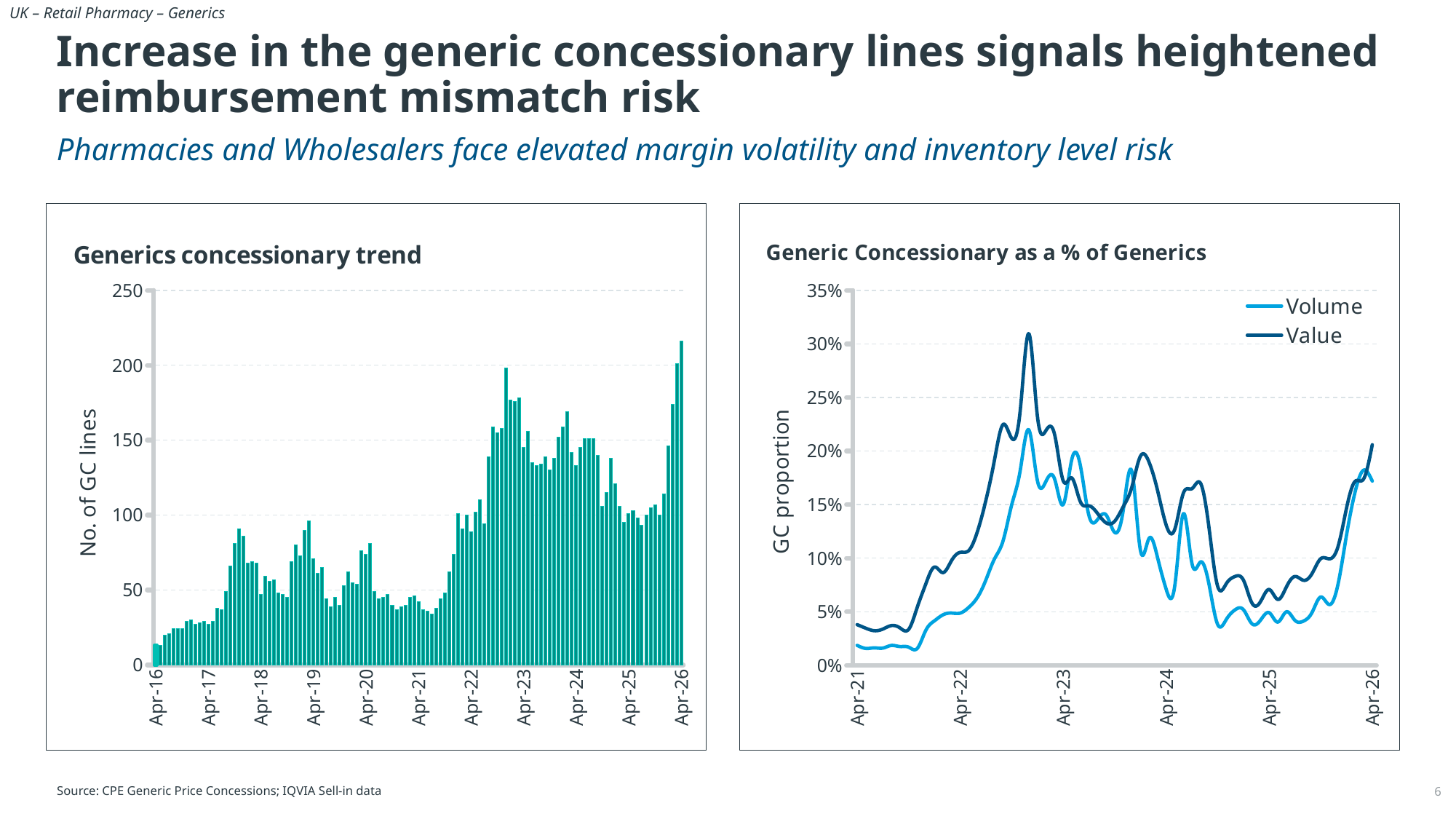
In the 'Generic Concessionary as a % of Generics' chart, is the peak of the Value line greater or less than 25%? greater In the 'Generics concessionary trend' chart, is the number of GC lines at Apr-26 greater or less than 200? greater In the 'Generics concessionary trend' chart, which month shown on the x axis has the highest bar? Apr-26 What is the y-axis label of the 'Generic Concessionary as a % of Generics' chart? GC proportion In the 'Generics concessionary trend' chart, is the number of GC lines at Apr-18 greater or less than 100? less What type of chart is the 'Generics concessionary trend' chart on the left? bar chart In the 'Generics concessionary trend' chart, do the bars rise or fall between Apr-25 and Apr-26? rise What type of chart is the 'Generic Concessionary as a % of Generics' chart on the right? line chart In the 'Generic Concessionary as a % of Generics' chart, which series reaches the higher peak, Volume or Value? Value How many series does the legend of the 'Generic Concessionary as a % of Generics' chart list? 2